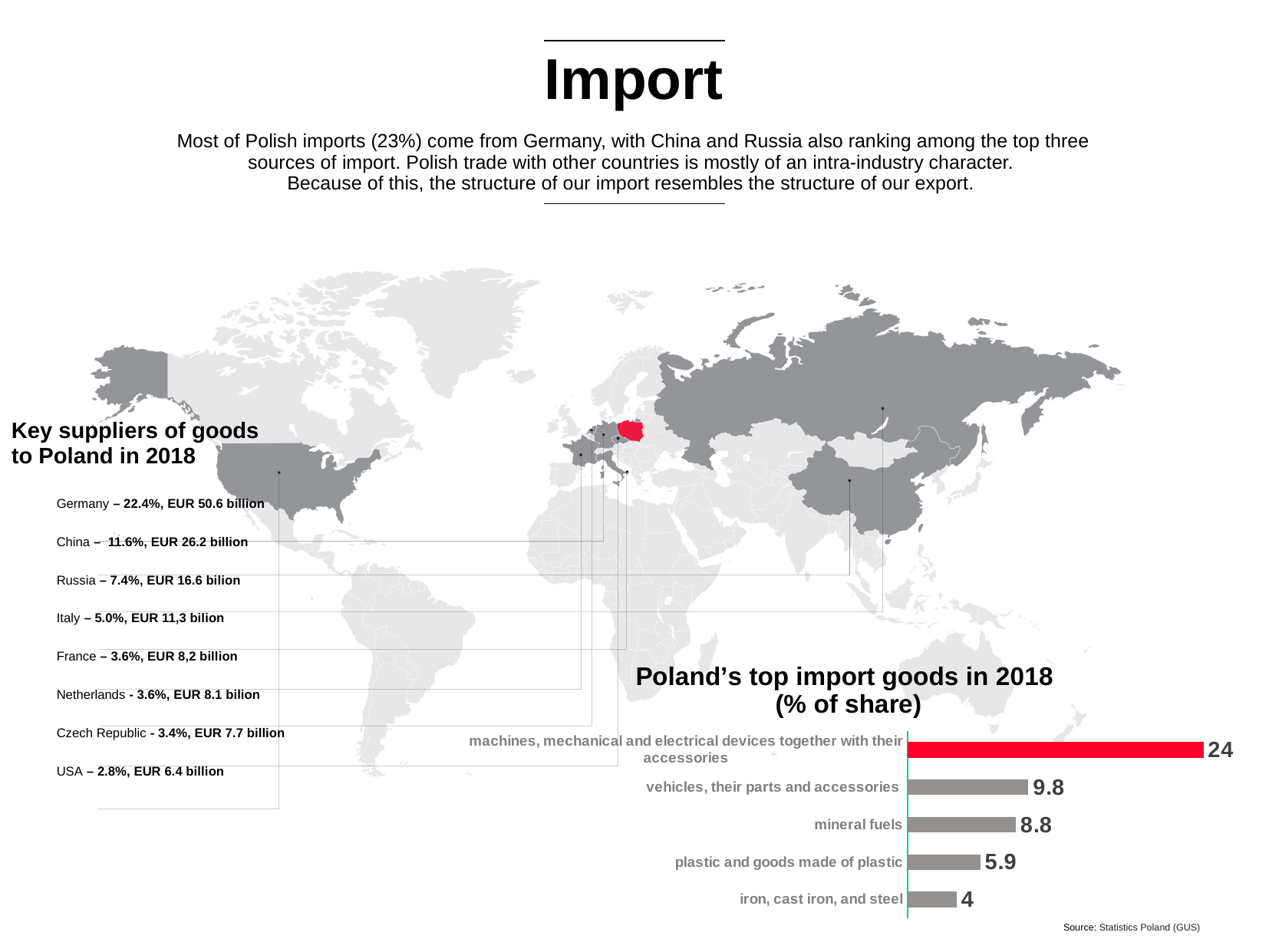
In the chart 'Poland's top import goods in 2018 (% of share)', what is the value for plastic and goods made of plastic? 5.9 In the chart 'Poland's top import goods in 2018 (% of share)', which is larger: the value for mineral fuels or the value for plastic and goods made of plastic? mineral fuels In the chart 'Poland's top import goods in 2018 (% of share)', which category has the lowest value? iron, cast iron, and steel In the chart 'Poland's top import goods in 2018 (% of share)', which category has the highest value? machines, mechanical and electrical devices together with their accessories In the chart 'Poland's top import goods in 2018 (% of share)', what is the difference between the value for mineral fuels and the value for iron, cast iron, and steel? 4.8 How many categories are shown in the chart 'Poland's top import goods in 2018 (% of share)'? 5 In the chart 'Poland's top import goods in 2018 (% of share)', what is the difference between the value for machines, mechanical and electrical devices together with their accessories and the value for vehicles, their parts and accessories? 14.2 In the chart 'Poland's top import goods in 2018 (% of share)', what is the value for mineral fuels? 8.8 What kind of chart is 'Poland's top import goods in 2018 (% of share)'? bar chart In the chart 'Poland's top import goods in 2018 (% of share)', what is the value for iron, cast iron, and steel? 4 In the chart 'Poland's top import goods in 2018 (% of share)', what is the value for vehicles, their parts and accessories? 9.8 In the chart 'Poland's top import goods in 2018 (% of share)', which bar is coloured red rather than grey? machines, mechanical and electrical devices together with their accessories